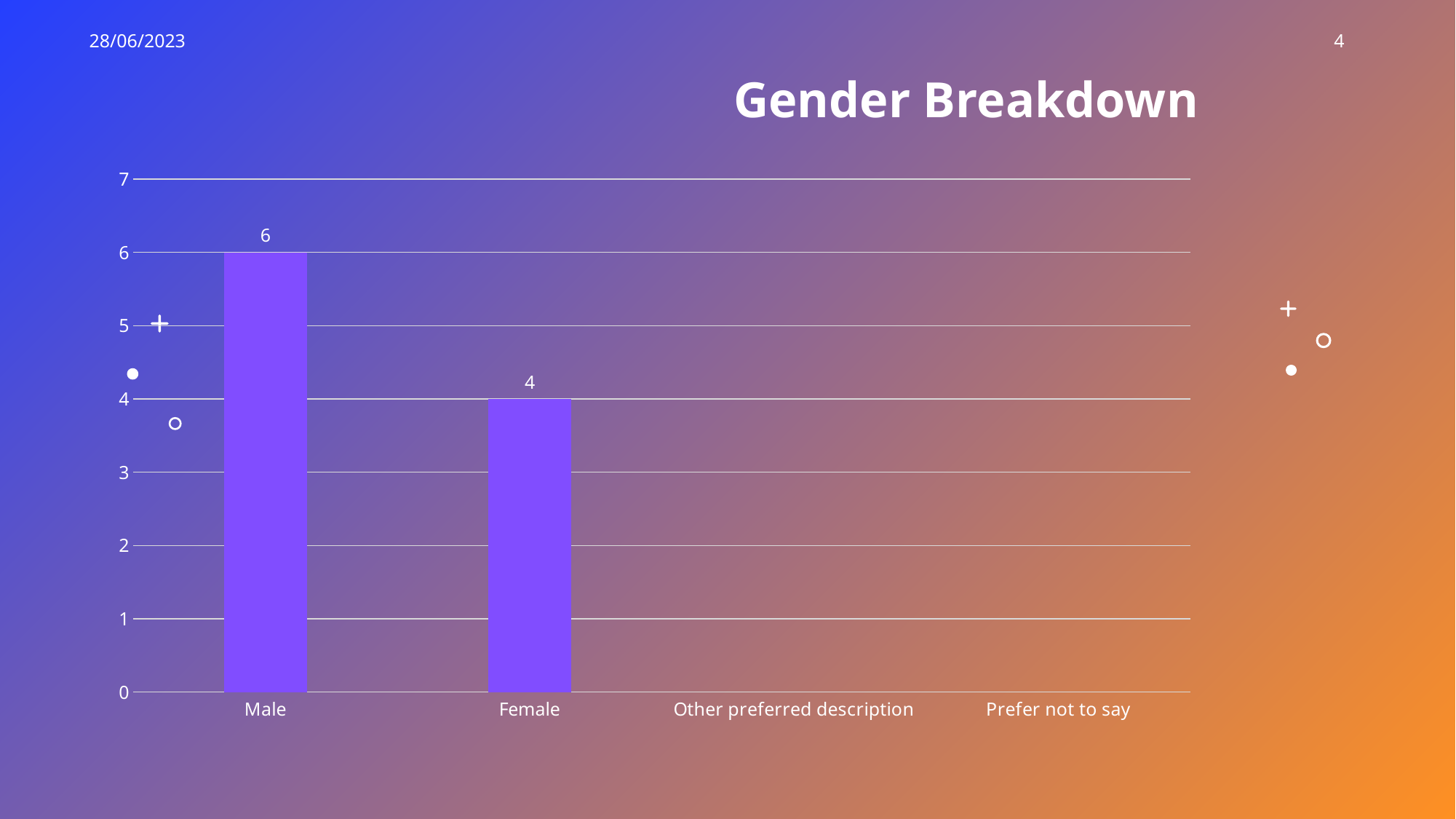
What kind of chart is shown on the slide? bar chart Is the value for Female greater or less than 5? less Which category has the highest value? Male What is the value for Female? 4 How many categories are shown on the x axis? 4 What is the title of the chart? Gender Breakdown How many categories have a visible bar? 2 What is the difference between the values for Male and Female? 2 Which is larger, the value for Male or the value for Female? Male Is the value for Male greater or less than 5? greater What is the value for Male? 6 What is the highest value shown on the y axis? 7